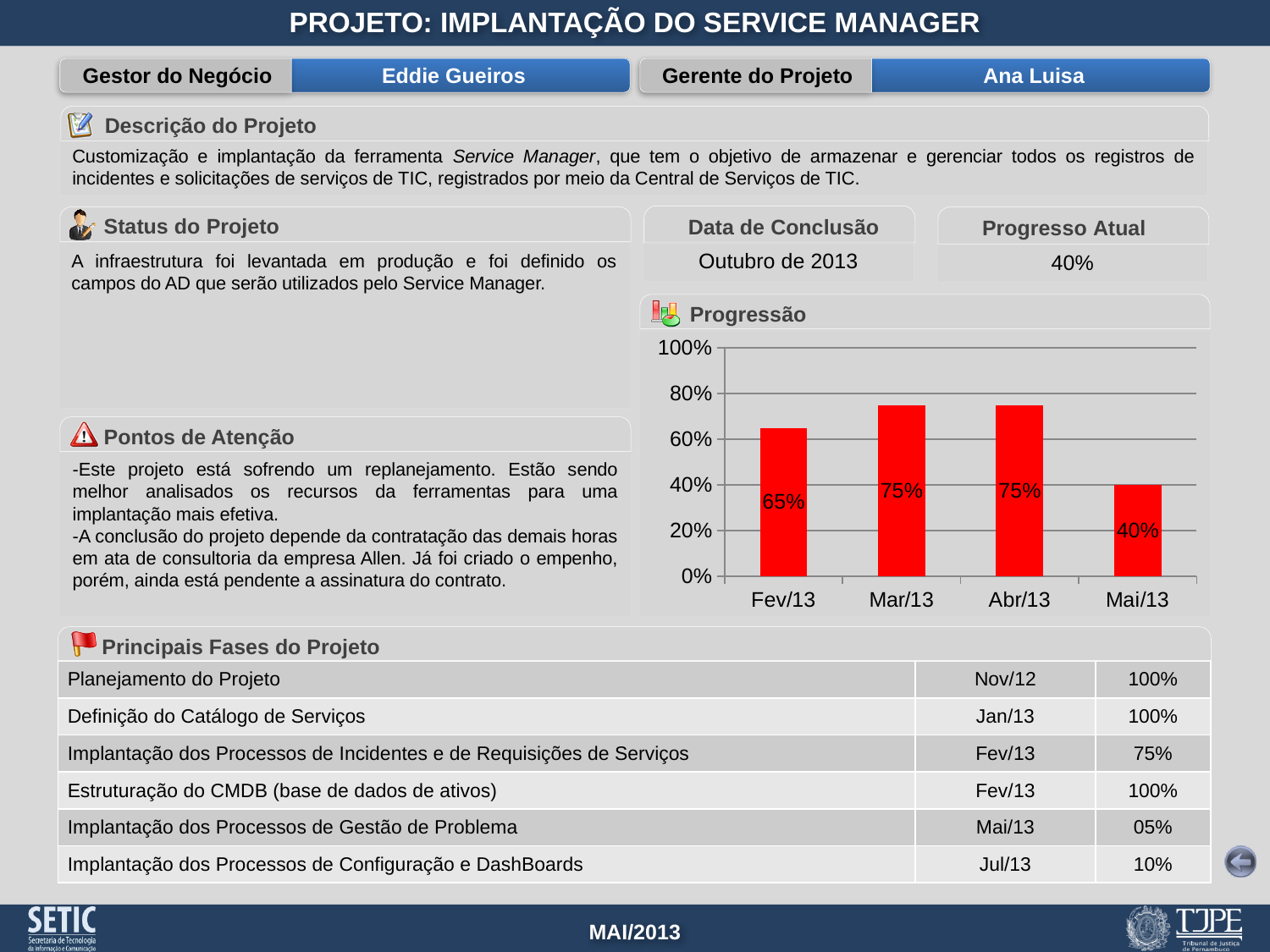
What is the value for Mai/13 in the Progressão chart? 40% What colour are the bars in the Progressão chart? red Which category has the lowest value in the Progressão chart? Mai/13 What is the difference between the values for Mar/13 and Fev/13 in the Progressão chart? 10% Is the value for Abr/13 in the Progressão chart greater or less than 60%? greater How many categories are shown on the x axis of the Progressão chart? 4 What kind of chart is the Progressão chart? bar chart What is the value for Mar/13 in the Progressão chart? 75% Which is larger in the Progressão chart, the value for Fev/13 or the value for Mai/13? Fev/13 What is the difference between the values for Fev/13 and Mai/13 in the Progressão chart? 25% What is the value for Fev/13 in the Progressão chart? 65% Do the values in the Progressão chart rise or fall from Abr/13 to Mai/13? fall